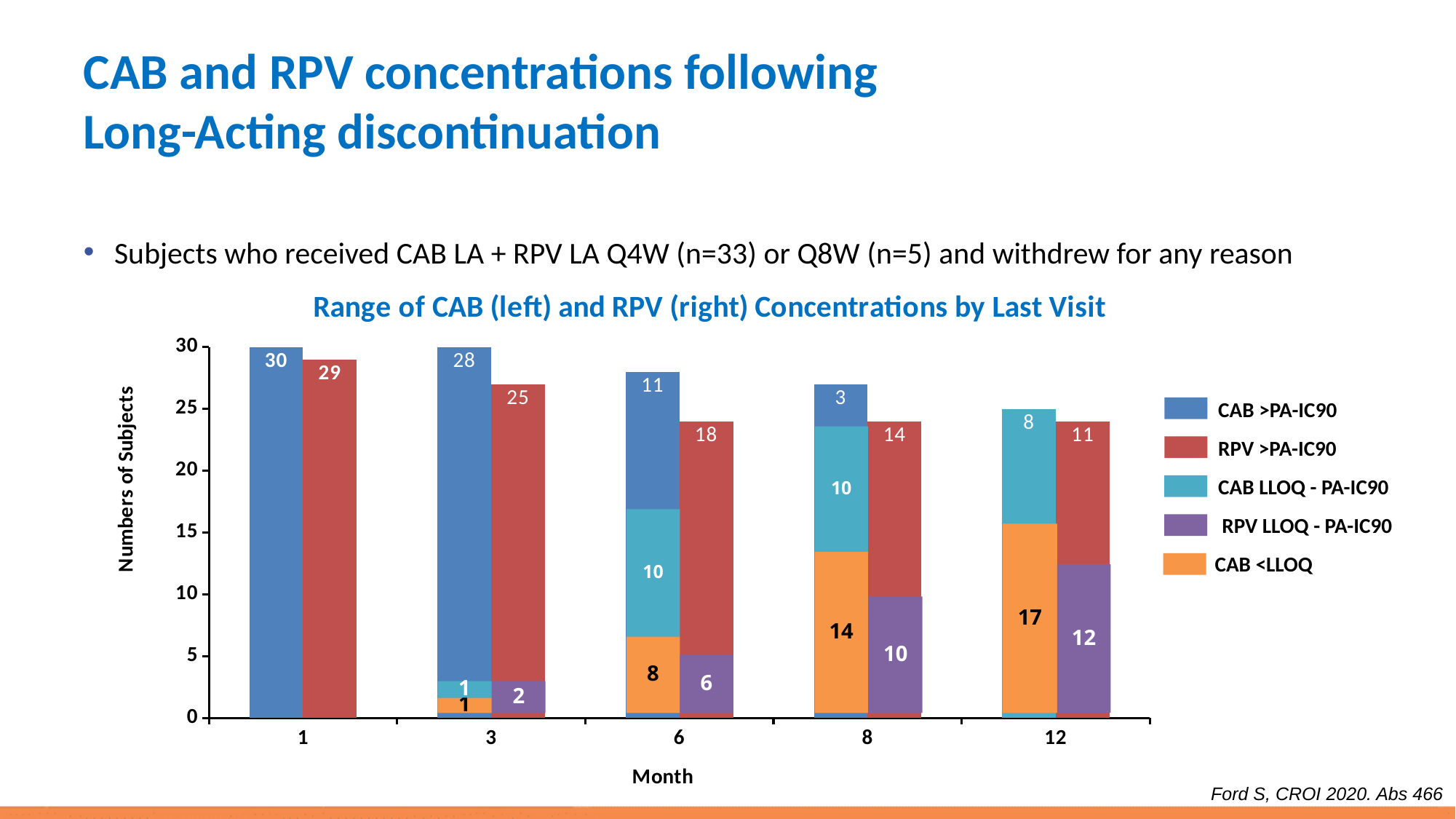
What is the value for RPV LLOQ - PA-IC90 at month 8? 10 How many months are shown on the x axis? 5 What is the total of the stacked RPV bar at month 6? 24 What kind of chart is shown on the slide? Stacked bar chart What is the difference between CAB <LLOQ at month 8 and CAB <LLOQ at month 6? 6 At which month is the CAB >PA-IC90 value highest? 1 What is the value for CAB >PA-IC90 at month 1? 30 Which is larger at month 6: RPV >PA-IC90 or CAB >PA-IC90? RPV >PA-IC90 What is the value for RPV >PA-IC90 at month 3? 25 At which month is the RPV >PA-IC90 value lowest? 12 How many series does the legend list? 5 What is the value for CAB <LLOQ at month 12? 17